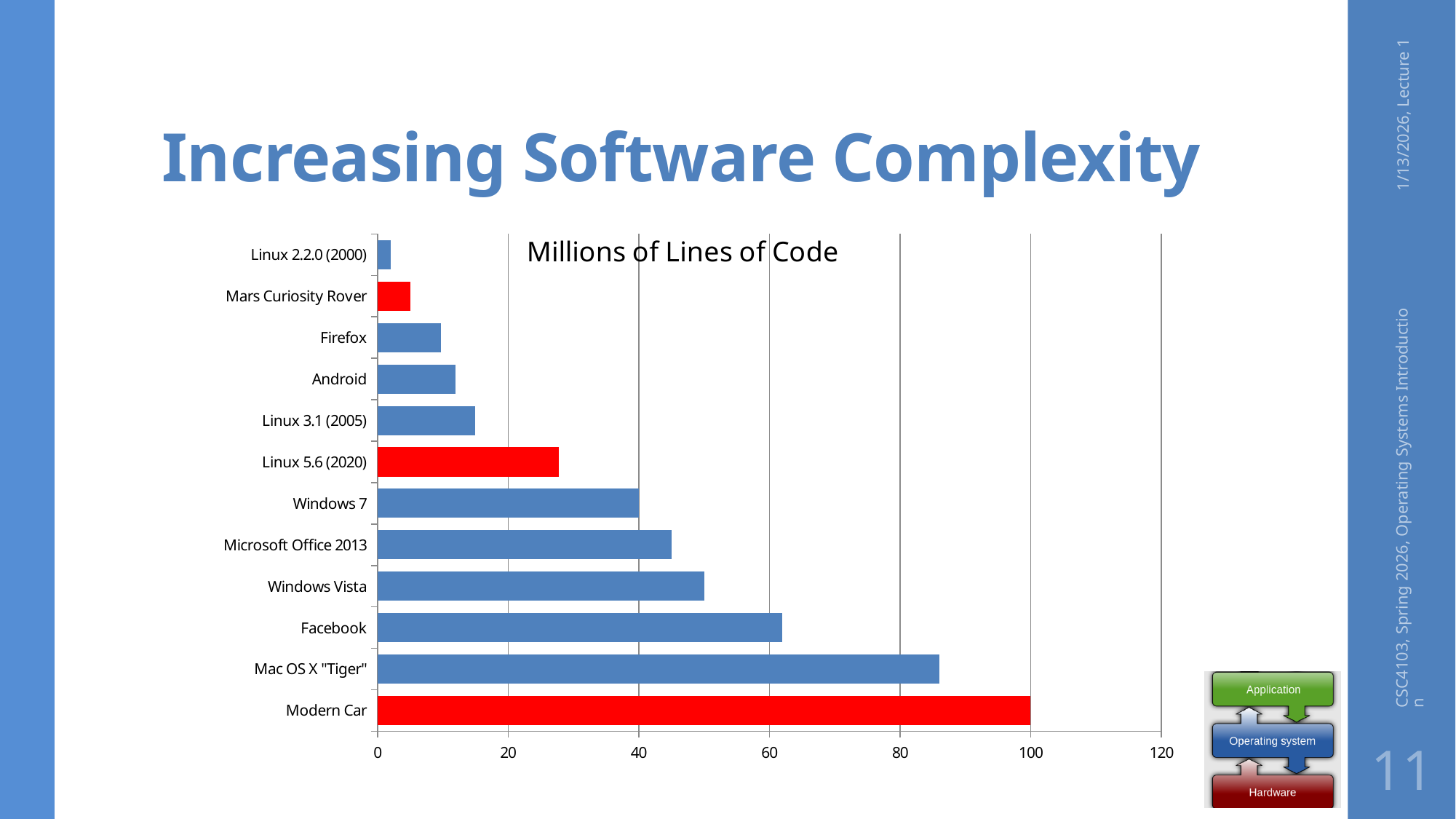
What is the value for Modern Car? 100 Which has a larger value, Facebook or Windows Vista? Facebook Is the value for Firefox greater or less than 20? less Which bars in the chart are coloured red? Mars Curiosity Rover, Linux 5.6 (2020), Modern Car What kind of chart is shown on the slide? bar chart Which category has the lowest value in the chart? Linux 2.2.0 (2000) What is the title of the chart? Millions of Lines of Code Which category has the highest value in the chart? Modern Car How many categories are plotted in the chart? 12 What is the difference between the values for Modern Car and Windows 7? 60 What is the value for Windows 7? 40 Is the value for Mac OS X "Tiger" greater or less than 80? greater